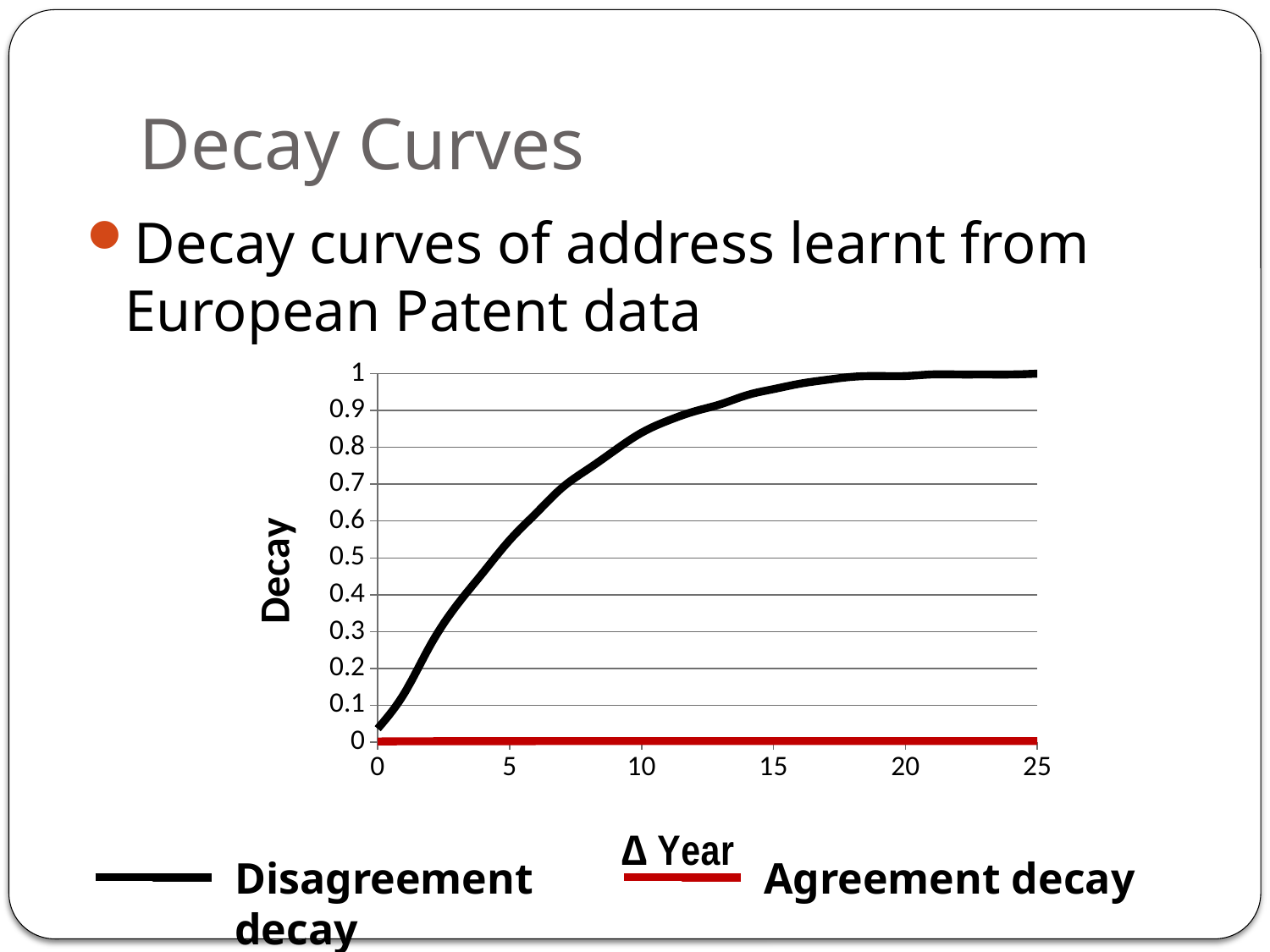
What is the label of the y axis? Decay What kind of chart is shown on the slide? line chart Is the value of Disagreement decay at Δ Year 1 greater or less than 0.2? less Is the value of Disagreement decay at Δ Year 20 greater or less than 0.9? greater Is the value of Disagreement decay at Δ Year 15 greater or less than 0.9? greater What colour is the Agreement decay line? red Which series has the larger value at Δ Year 10, Disagreement decay or Agreement decay? Disagreement decay Does the Disagreement decay curve rise or fall as Δ Year increases? rises How many series does the legend list? 2